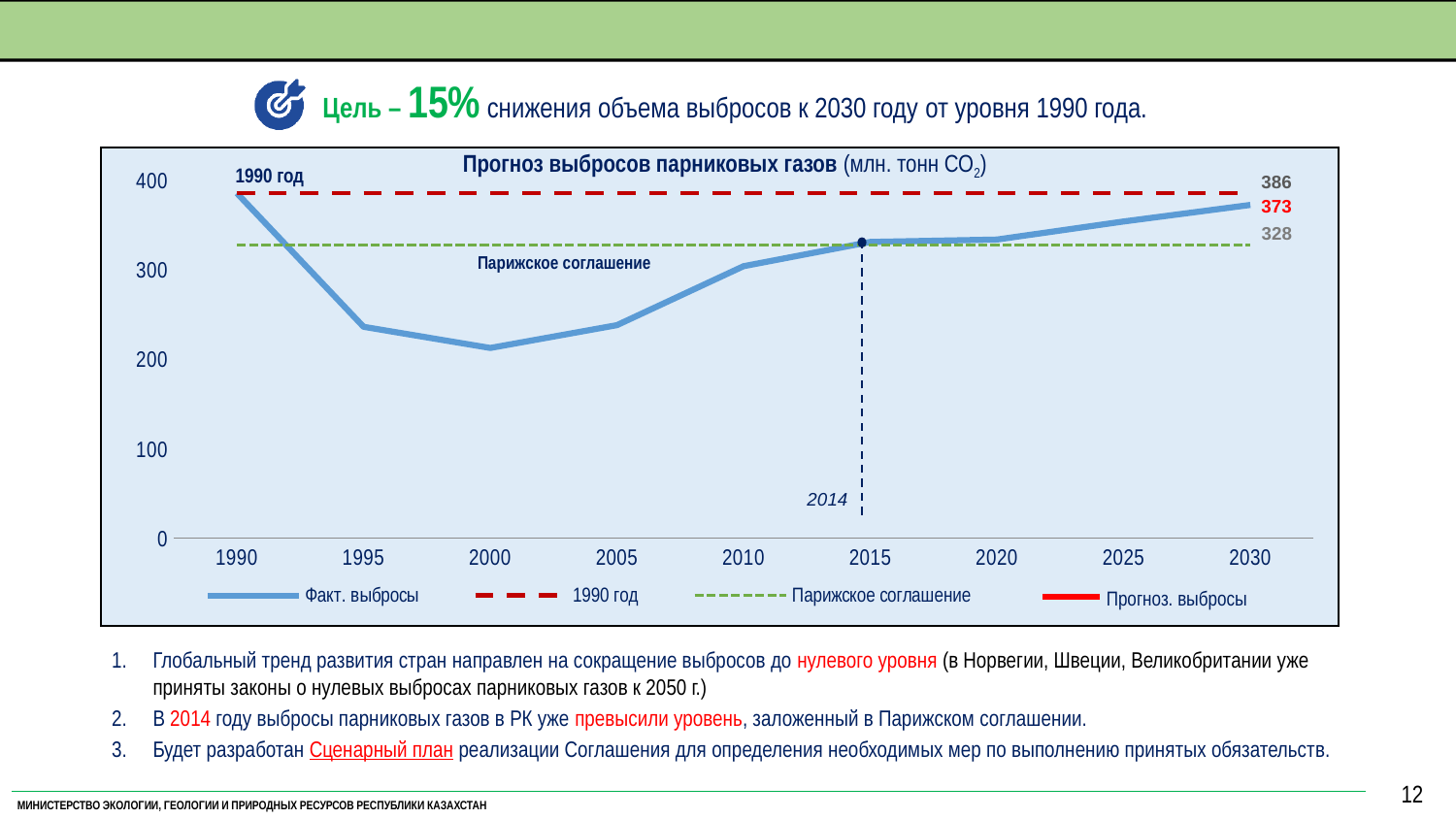
In which year does the Факт. выбросы line reach its lowest point? 2000 What is the difference between the 1990 level (386) and the 2030 forecast (373)? 13 What value is labelled for the forecast emissions at 2030? 373 What kind of chart is shown on the slide? line chart Which year is marked by the vertical dashed line on the chart? 2014 What is the difference between the 1990 level (386) and the Paris Agreement level (328)? 58 How many series does the chart legend list? 4 Is the value of Факт. выбросы in 2020 greater or less than 300? greater Is the value of Факт. выбросы in 2000 greater or less than 300? less Do the emissions rise or fall along the x axis from 2000 to 2030? rise What value is labelled for the 1990 год (1990 level) line on the right side of the chart? 386 What value is labelled for the Парижское соглашение (Paris Agreement) line? 328